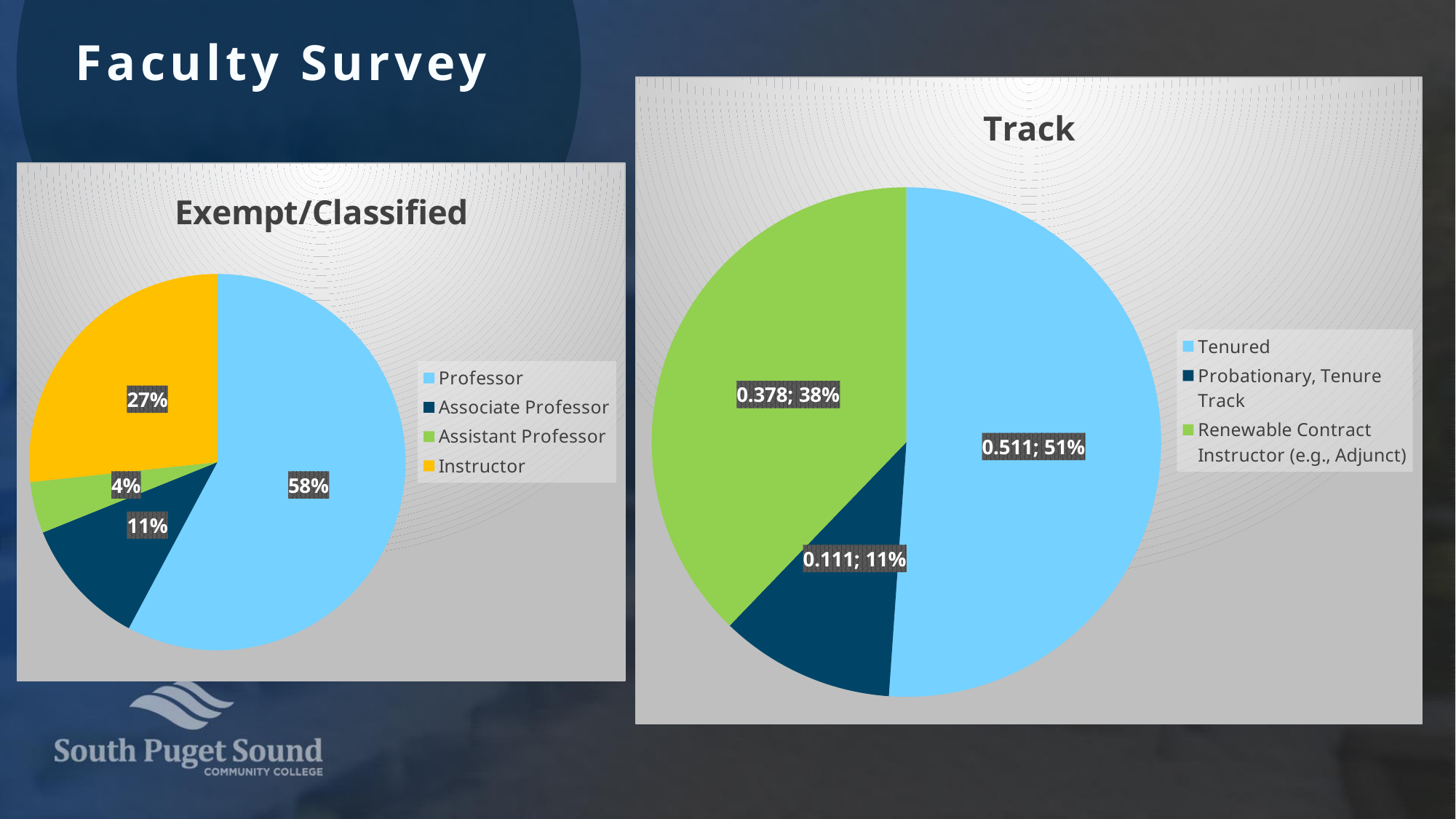
In the Exempt/Classified chart, what share of the pie is Professor? 58% In the Exempt/Classified chart, which category has the smallest slice? Assistant Professor In the Track chart, which is larger, Tenured or Renewable Contract Instructor (e.g., Adjunct)? Tenured In the Exempt/Classified chart, which category has the largest slice? Professor In the Exempt/Classified chart, what percentage is shown for Instructor? 27% How many categories does the Exempt/Classified chart's legend list? 4 In the Track chart, what value label is shown for Renewable Contract Instructor (e.g., Adjunct)? 0.378; 38% In the Track chart, which category has the smallest slice? Probationary, Tenure Track What kind of chart is the Track chart? Pie chart In the Track chart, what colour is the Probationary, Tenure Track slice? Dark blue In the Track chart, what percentage is shown for Tenured? 51% In the Exempt/Classified chart, what is the difference in percentage points between Instructor and Associate Professor? 16